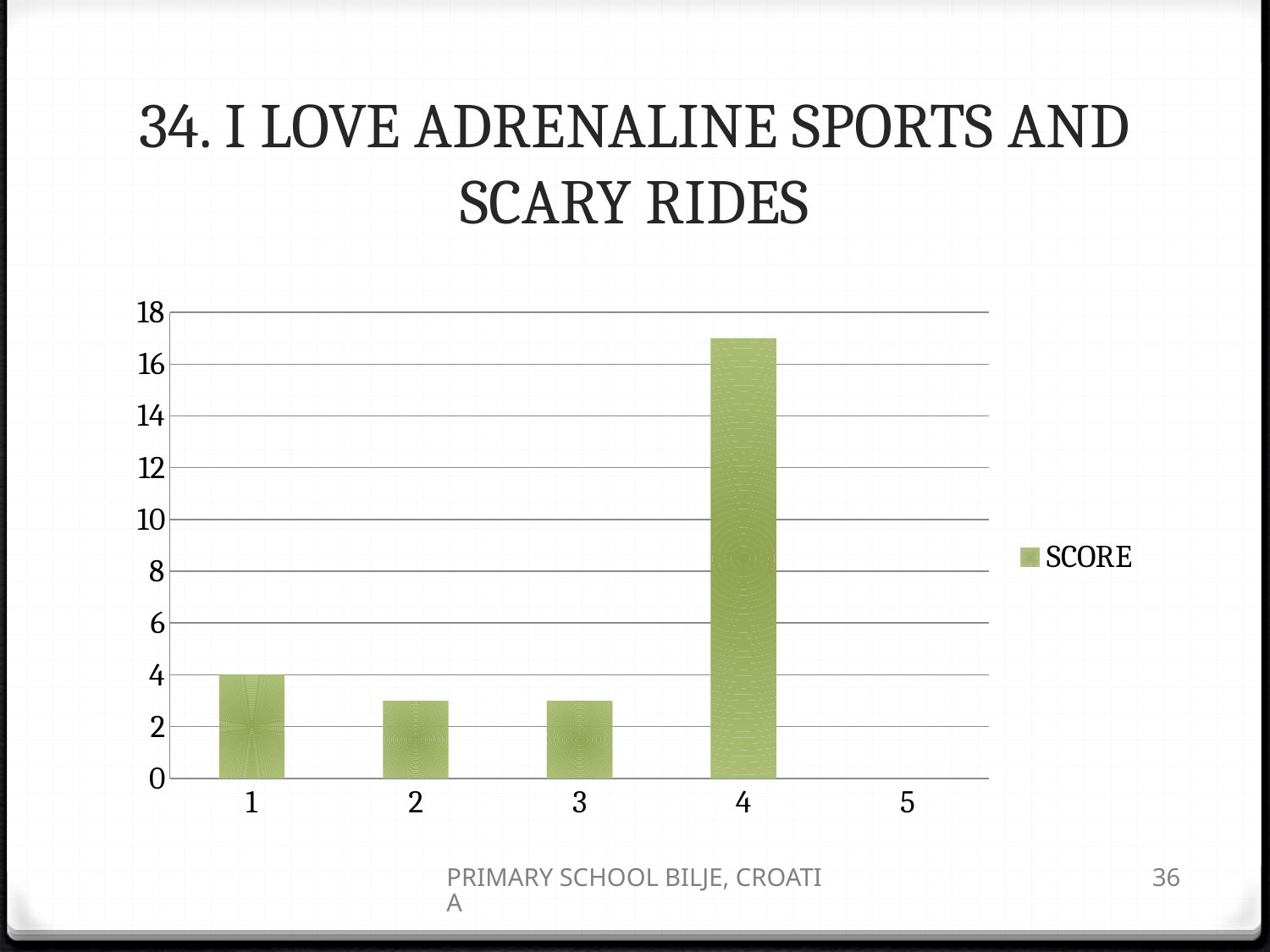
Is the SCORE value for category 4 greater or less than 16? greater Is the SCORE value for category 2 greater or less than 4? less How many categories are shown on the x axis? 5 Is the SCORE value for category 3 greater or less than 2? greater Which category has the highest SCORE? 4 What is the name of the series shown in the legend? SCORE Which category has the lowest SCORE? 5 What is the SCORE value for category 5? 0 Which has a larger SCORE, category 1 or category 2? category 1 How many series does the legend list? 1 What is the SCORE value for category 1? 4 What type of chart is shown on the slide? bar chart